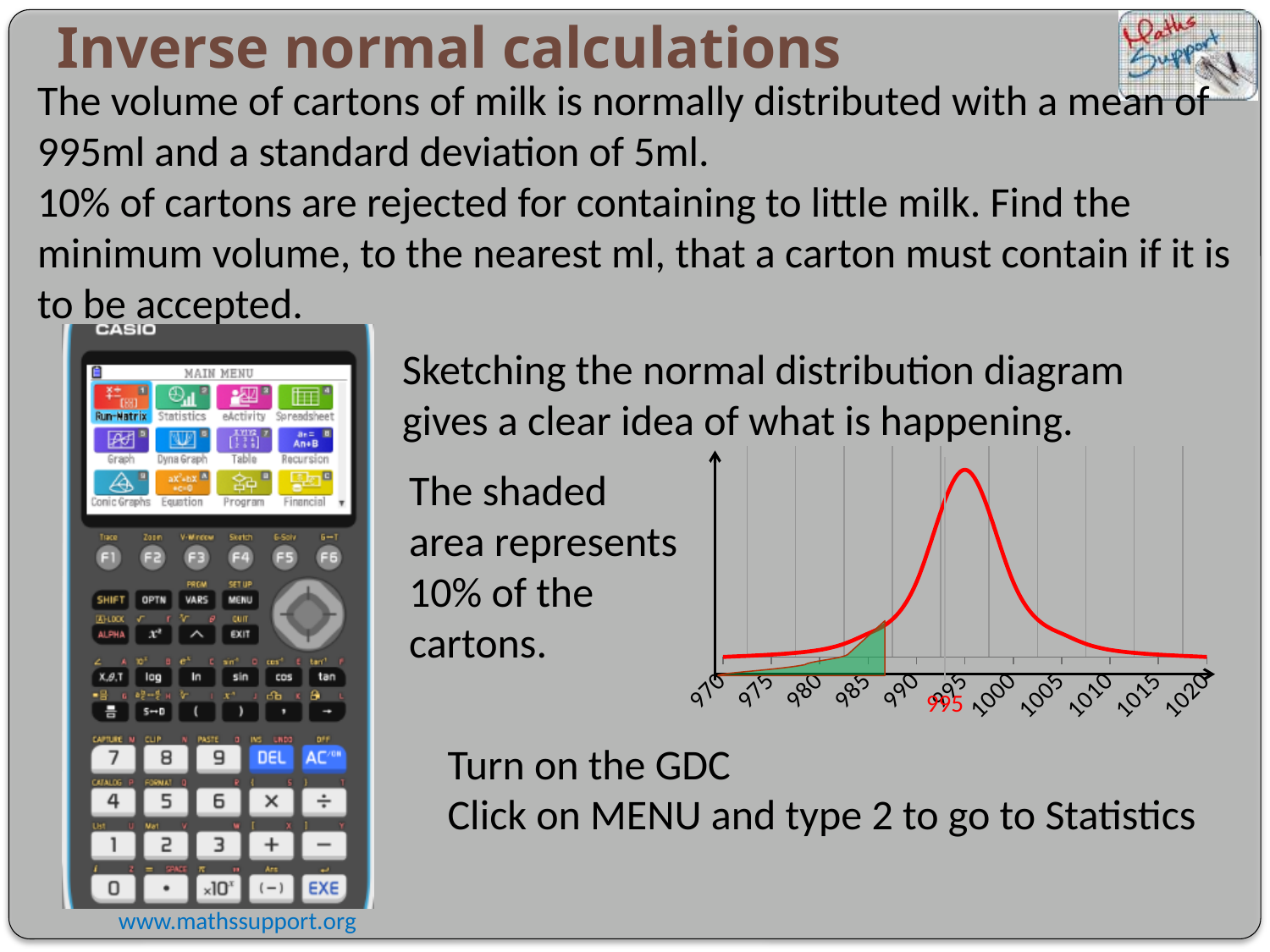
At which x-axis value does the red curve reach its peak? 995 Is the shaded region of the diagram located below or above 990 on the x axis? below Does the red curve rise or fall as x increases from 995 to 1020? fall How many labelled tick values are shown on the x axis of the normal distribution diagram? 11 What kind of chart is the normal distribution diagram on the slide? line chart What colour is the shaded area under the curve? green What is the highest value labelled on the x axis of the normal distribution diagram? 1020 What share of the cartons does the shaded area of the diagram represent? 10% What is the lowest value labelled on the x axis of the normal distribution diagram? 970 Does the red curve rise or fall as x increases from 970 to 995? rise Which x-axis value on the diagram is written in red? 995